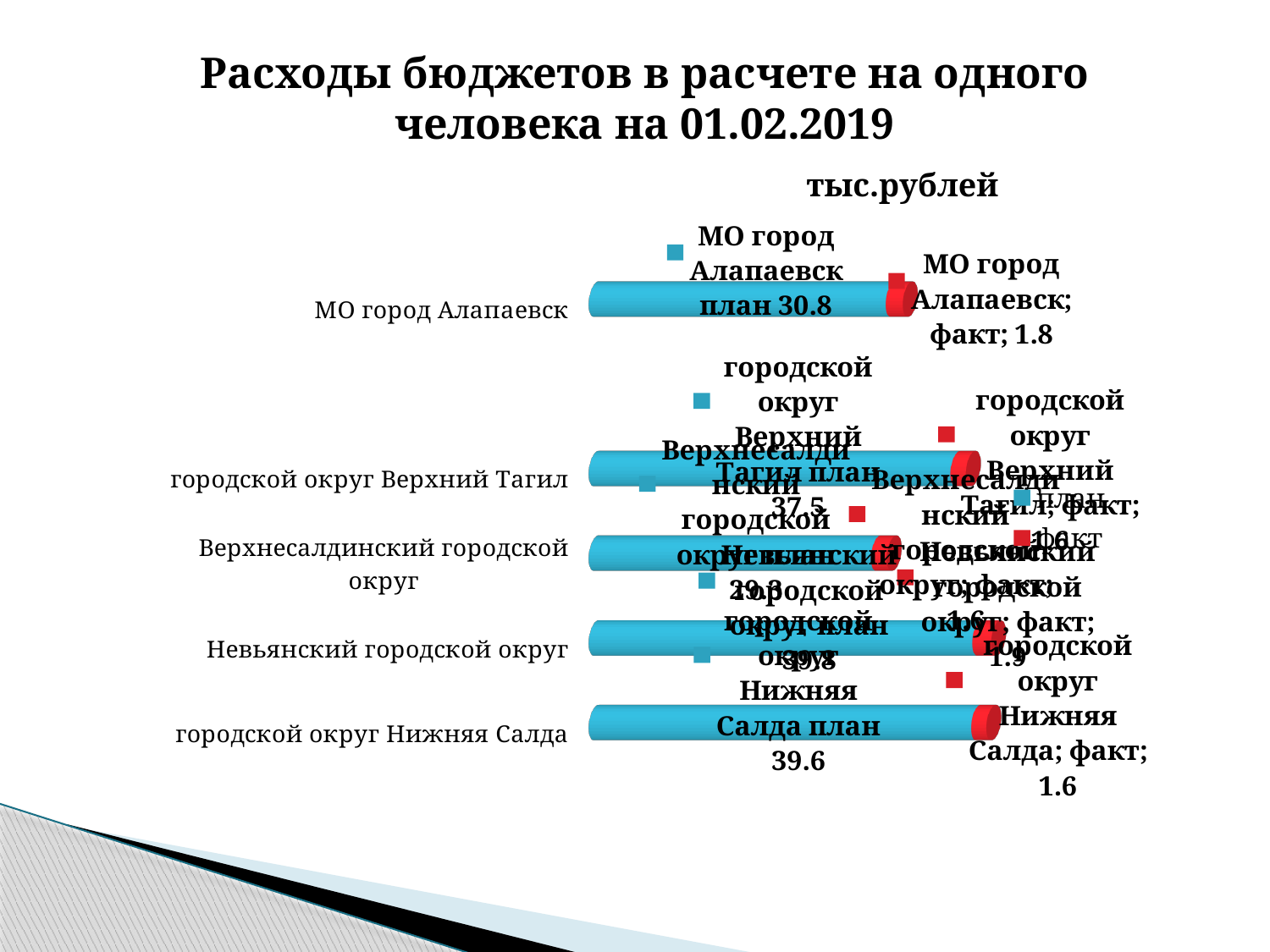
What is the план value for городской округ Нижняя Салда? 39.6 What kind of chart is shown on the slide? bar chart What is the план value for городской округ Верхний Тагил? 37.5 In what units are the values on the chart expressed, according to the label above the chart? тыс.рублей What is the difference between the план values of городской округ Нижняя Салда and городской округ Верхний Тагил? 2.1 How many municipalities (categories) are shown on the chart? 5 What is the план (plan) value for МО город Алапаевск? 30.8 What is the факт value for городской округ Нижняя Салда? 1.6 What is the факт (actual) value for МО город Алапаевск? 1.8 What is the difference between the план and факт values for МО город Алапаевск? 29.0 How many series does the chart's legend list? 2 Which has the larger план value: городской округ Нижняя Салда or МО город Алапаевск? городской округ Нижняя Салда